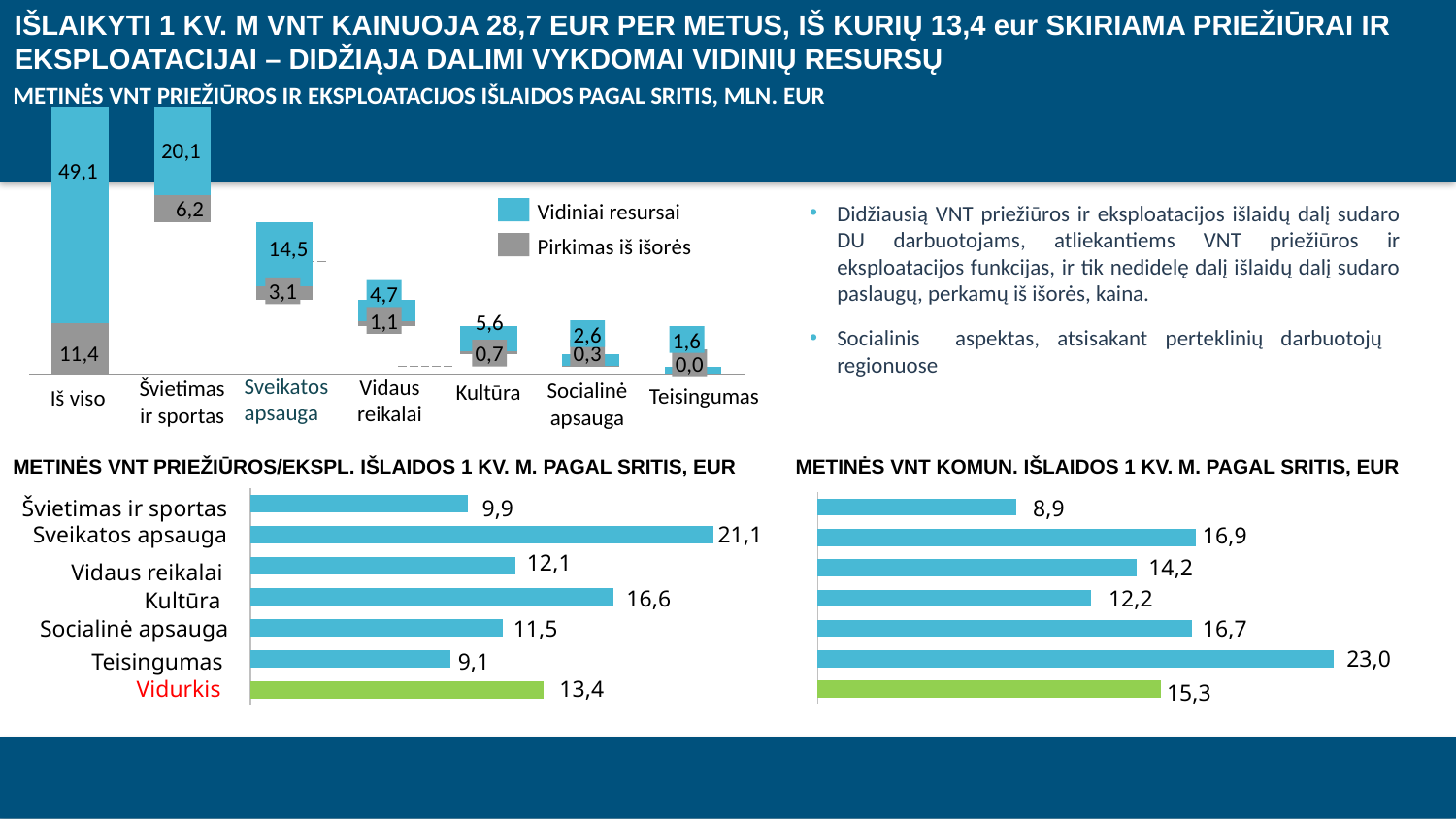
In the top chart 'METINĖS VNT PRIEŽIŪROS IR EKSPLOATACIJOS IŠLAIDOS PAGAL SRITIS, MLN. EUR', what is the total of the stacked bar for Sveikatos apsauga? 17,6 In the top chart 'METINĖS VNT PRIEŽIŪROS IR EKSPLOATACIJOS IŠLAIDOS PAGAL SRITIS, MLN. EUR', what is the difference between the Vidiniai resursai values for Kultūra and Vidaus reikalai? 0,9 What kind of chart is the bottom-right chart 'METINĖS VNT KOMUN. IŠLAIDOS 1 KV. M. PAGAL SRITIS, EUR'? Bar chart In the bottom-left chart 'METINĖS VNT PRIEŽIŪROS/EKSPL. IŠLAIDOS 1 KV. M. PAGAL SRITIS, EUR', which category has the highest value? Sveikatos apsauga In the top chart 'METINĖS VNT PRIEŽIŪROS IR EKSPLOATACIJOS IŠLAIDOS PAGAL SRITIS, MLN. EUR', what is the Vidiniai resursai value for Iš viso? 49,1 In the bottom-left chart 'METINĖS VNT PRIEŽIŪROS/EKSPL. IŠLAIDOS 1 KV. M. PAGAL SRITIS, EUR', what is the value for Vidurkis? 13,4 In the top chart 'METINĖS VNT PRIEŽIŪROS IR EKSPLOATACIJOS IŠLAIDOS PAGAL SRITIS, MLN. EUR', how many series does the legend list? 2 In the top chart 'METINĖS VNT PRIEŽIŪROS IR EKSPLOATACIJOS IŠLAIDOS PAGAL SRITIS, MLN. EUR', which category has the lowest Vidiniai resursai value? Teisingumas In the top chart 'METINĖS VNT PRIEŽIŪROS IR EKSPLOATACIJOS IŠLAIDOS PAGAL SRITIS, MLN. EUR', what is the Pirkimas iš išorės value for Švietimas ir sportas? 6,2 In the bottom-right chart 'METINĖS VNT KOMUN. IŠLAIDOS 1 KV. M. PAGAL SRITIS, EUR', what is the highest value shown? 23,0 In the bottom-left chart 'METINĖS VNT PRIEŽIŪROS/EKSPL. IŠLAIDOS 1 KV. M. PAGAL SRITIS, EUR', what is the value for Kultūra? 16,6 In the bottom-left chart 'METINĖS VNT PRIEŽIŪROS/EKSPL. IŠLAIDOS 1 KV. M. PAGAL SRITIS, EUR', which is larger: Vidaus reikalai or Socialinė apsauga? Vidaus reikalai